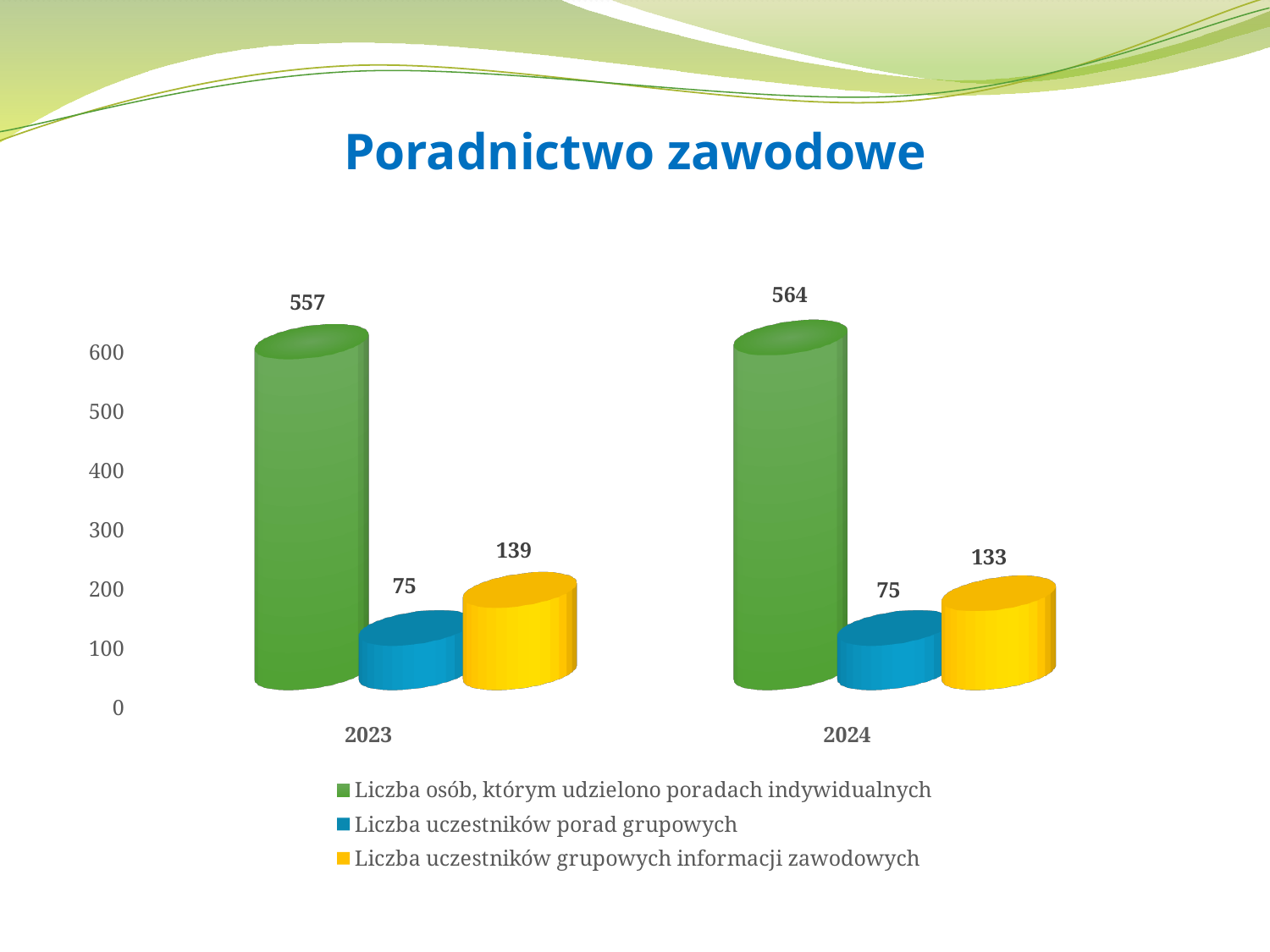
What kind of chart is shown on the slide? Bar chart Which year has the higher value for 'Liczba osób, którym udzielono poradach indywidualnych'? 2024 How many years are shown on the x axis? 2 Which series has the lowest value in 2024? Liczba uczestników porad grupowych What is the value for 'Liczba osób, którym udzielono poradach indywidualnych' in 2023? 557 What is the difference between the 2023 and 2024 values for 'Liczba uczestników grupowych informacji zawodowych'? 6 What is the title of the slide? Poradnictwo zawodowe What is the value for 'Liczba osób, którym udzielono poradach indywidualnych' in 2024? 564 How many series does the legend list? 3 What is the value for 'Liczba uczestników porad grupowych' in 2024? 75 What is the value for 'Liczba uczestników grupowych informacji zawodowych' in 2023? 139 What is the difference between the 2024 and 2023 values for 'Liczba osób, którym udzielono poradach indywidualnych'? 7